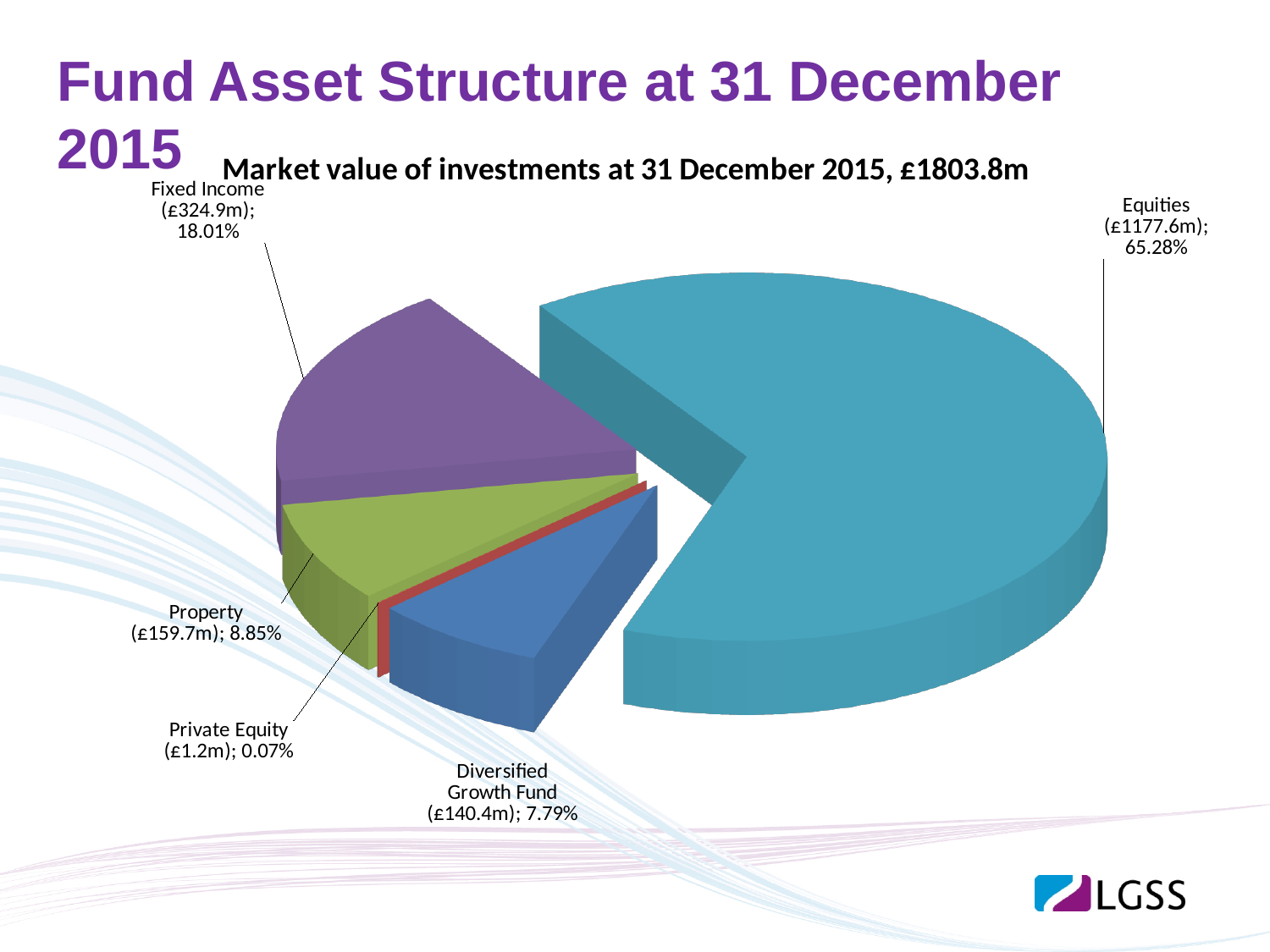
Which asset class has the largest share of the pie? Equities What kind of chart is shown on the slide? Pie chart What colour is the Equities slice? Teal/blue What is the total market value of investments given in the chart title? £1803.8m How many slices does the pie chart have? 5 What percentage share does the Diversified Growth Fund have? 7.79% What percentage share does Fixed Income have? 18.01% What is the difference in market value between Fixed Income and Property? £165.2m Which asset class has the smallest share of the pie? Private Equity Which is larger, the market value of Property or the Diversified Growth Fund? Property What is the market value of Equities? £1177.6m What is the market value of Property? £159.7m